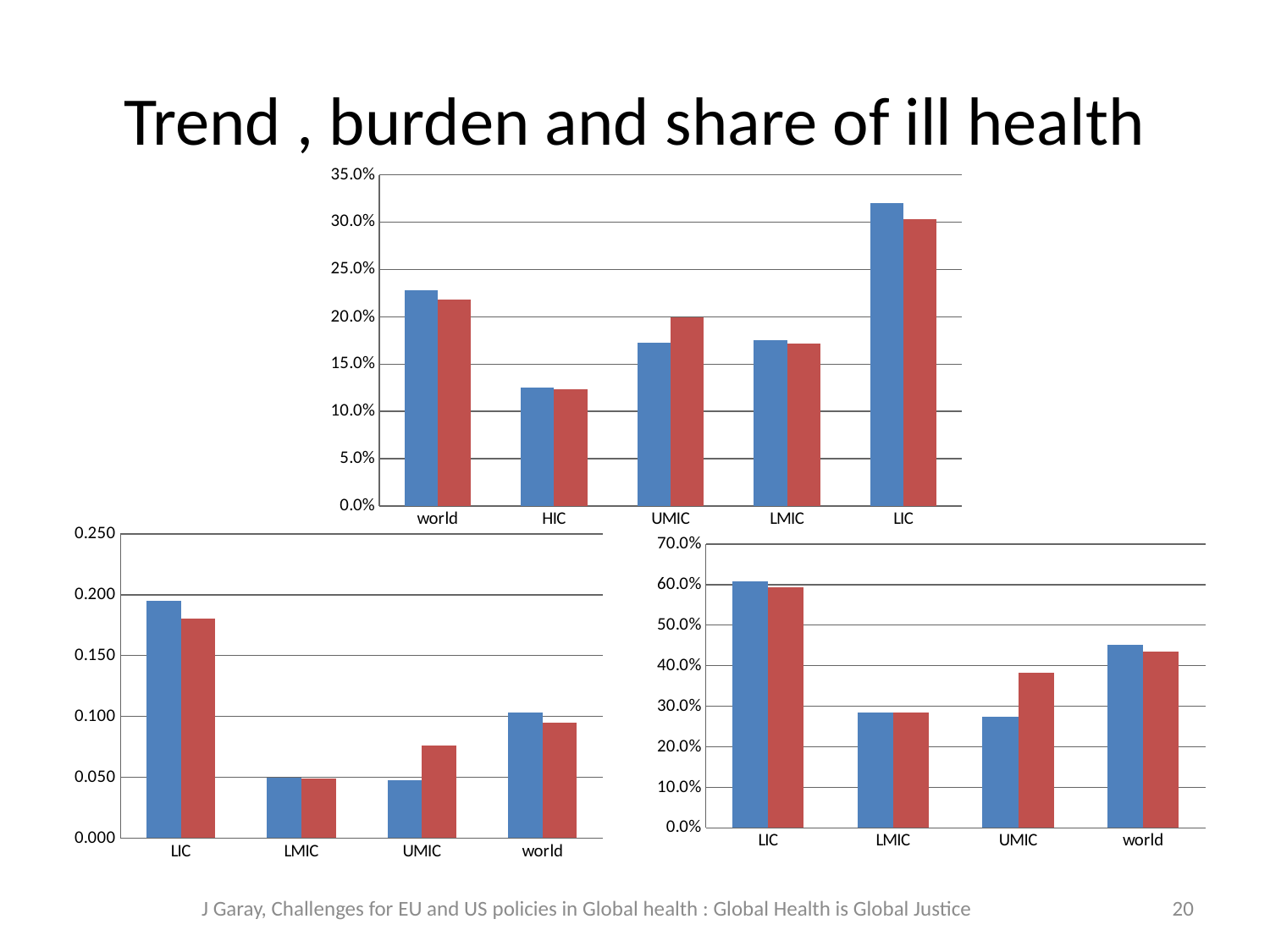
In the bottom-right chart, is the blue bar for LIC greater or less than 50.0%? greater In the bottom-left chart, how many categories are shown on the x axis? 4 In the top chart, is the blue bar for LIC greater or less than 30.0%? greater In the bottom-right chart, is the red bar for UMIC greater or less than 30.0%? greater In the top chart, which category has the lowest bars? HIC How many charts are shown on the slide? 3 In the top chart, how many categories are shown on the x axis? 5 In the bottom-left chart, for UMIC, is the blue bar or the red bar taller? red In the top chart, which category has the highest bars? LIC In the bottom-left chart, which category has the highest bars? LIC What kind of chart is the top chart on the slide? bar chart